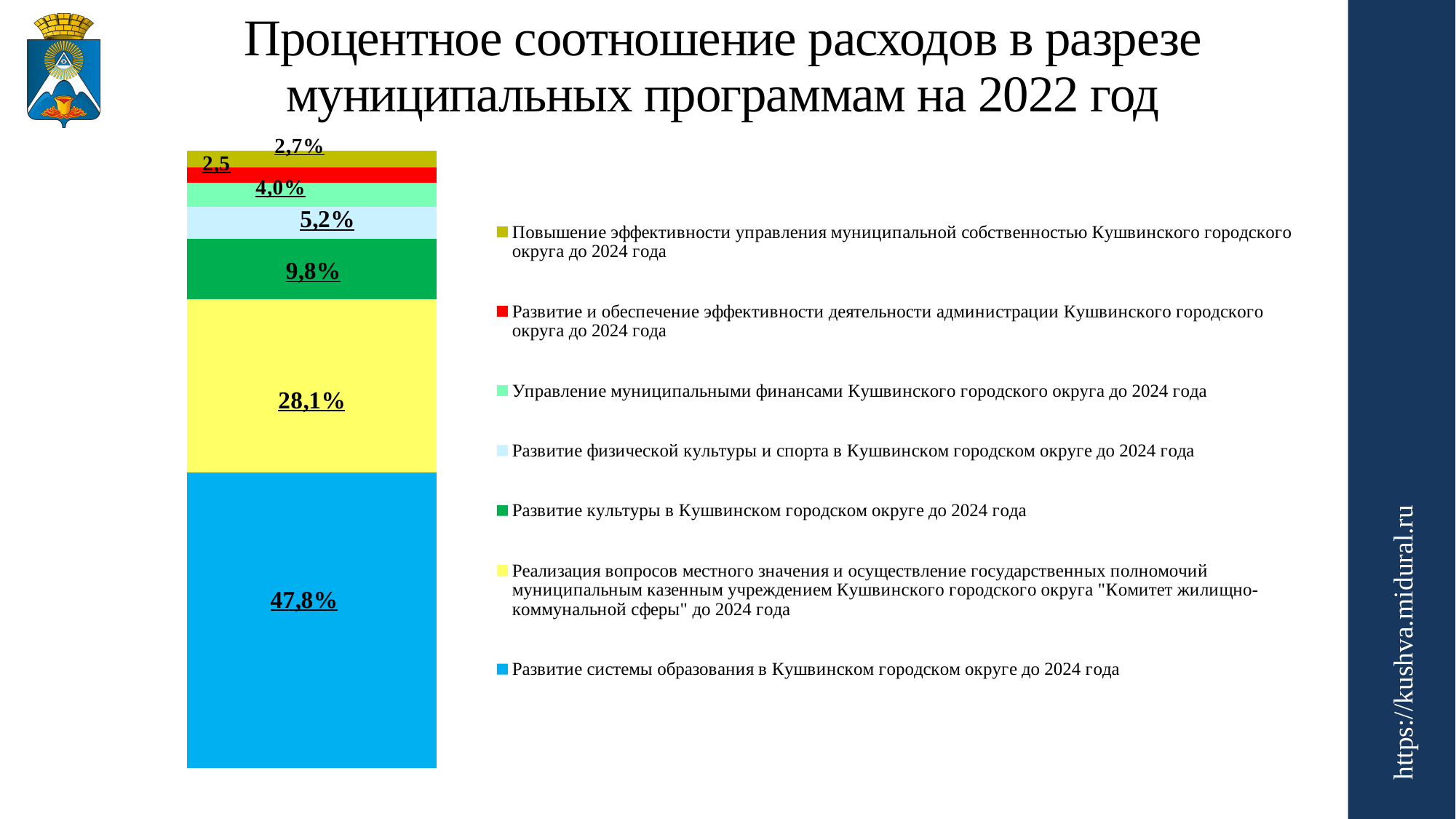
Which program has the largest share of expenditures? Развитие системы образования в Кушвинском городском округе до 2024 года Which program has the smallest share of expenditures? Развитие и обеспечение эффективности деятельности администрации Кушвинского городского округа до 2024 года What share is shown for 'Управление муниципальными финансами Кушвинского городского округа до 2024 года'? 4,0% What kind of chart is shown on the slide? Stacked bar chart How many programs (series) does the legend list? 7 What is the difference between the share for 'Развитие системы образования' (47,8%) and the share for 'Реализация вопросов местного значения ... Комитет жилищно-коммунальной сферы' (28,1%)? 19,7% What share is shown for 'Развитие физической культуры и спорта в Кушвинском городском округе до 2024 года'? 5,2% What value is shown for 'Повышение эффективности управления муниципальной собственностью Кушвинского городского округа до 2024 года'? 2,7% What share is shown for 'Развитие системы образования в Кушвинском городском округе до 2024 года'? 47,8% Which is larger: the share for 'Развитие культуры' or the share for 'Развитие физической культуры и спорта'? Развитие культуры What colour is the segment for 'Реализация вопросов местного значения ... Комитет жилищно-коммунальной сферы'? Yellow What share is shown for 'Развитие культуры в Кушвинском городском округе до 2024 года'? 9,8%